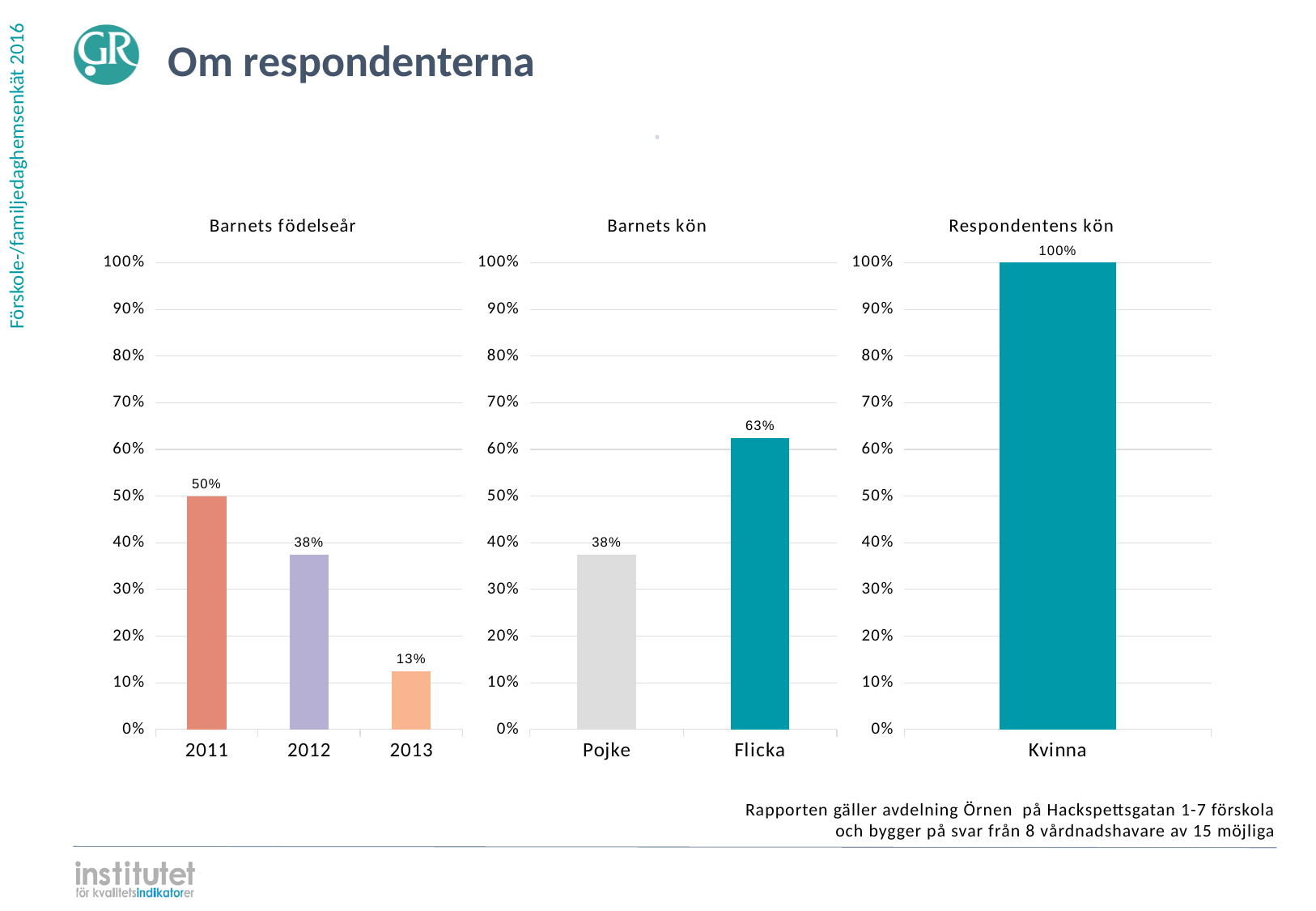
In the 'Barnets födelseår' chart, which birth year has the lowest value? 2013 In the 'Barnets kön' chart, which is larger, Pojke or Flicka? Flicka In the 'Barnets födelseår' chart, do the values rise or fall from 2011 to 2013? fall In the 'Respondentens kön' chart, what is the value for Kvinna? 100% In the 'Barnets kön' chart, what is the value for Flicka? 63% In the 'Barnets födelseår' chart, what is the difference between the values for 2011 and 2012? 12% In the 'Barnets födelseår' chart, what is the value for 2013? 13% What kind of chart is the 'Respondentens kön' chart? bar chart In the 'Barnets födelseår' chart, which birth year has the highest value? 2011 In the 'Barnets kön' chart, what is the difference between Flicka and Pojke? 25% In the 'Barnets födelseår' chart, how many birth years are shown? 3 In the 'Barnets födelseår' chart, what is the value for 2011? 50%